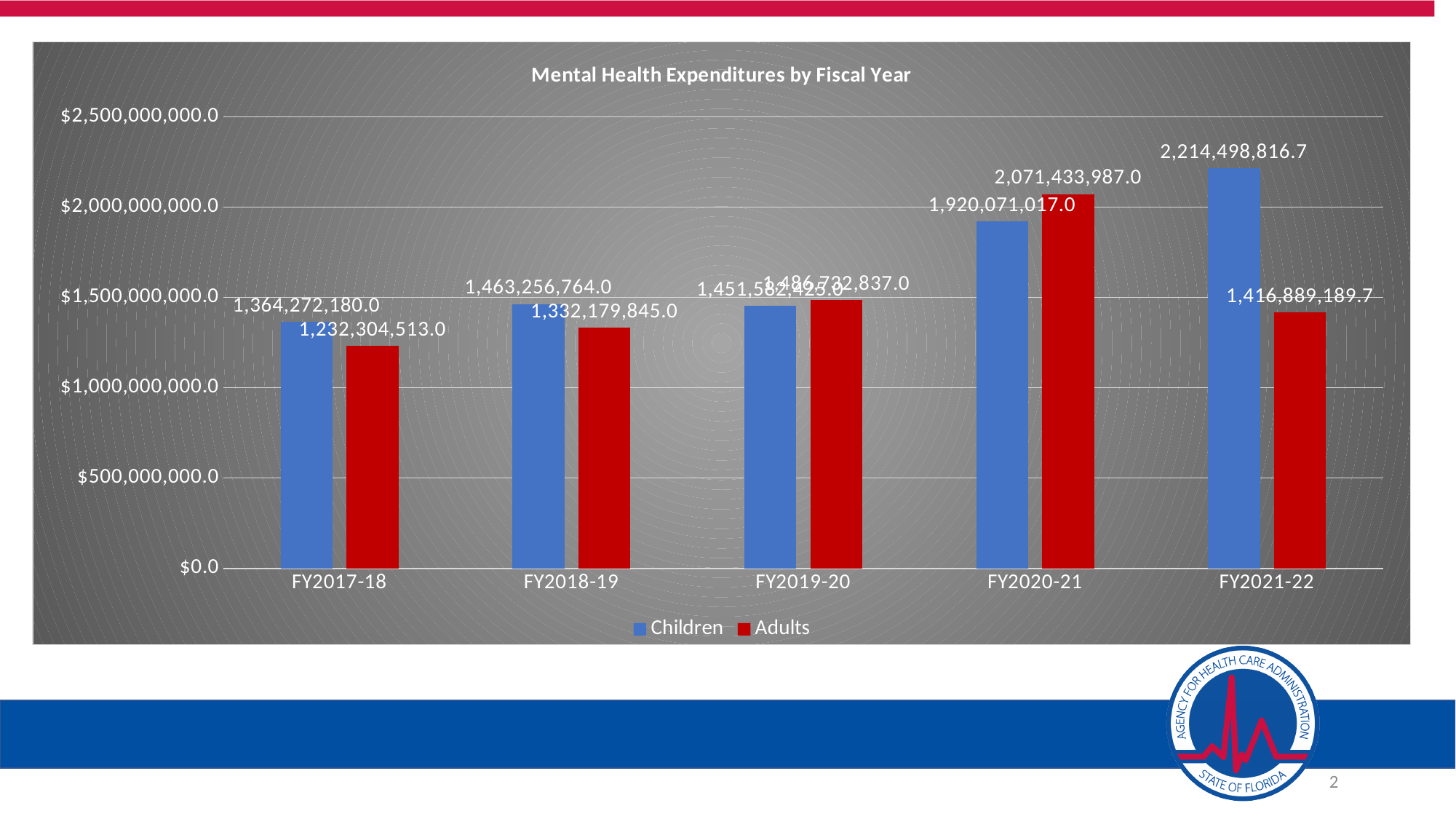
What is the Children expenditure for FY2017-18? 1,364,272,180.0 How many series does the legend list? 2 Is the Adults expenditure for FY2021-22 greater or less than $1,500,000,000.0? less What is the Adults expenditure for FY2021-22? 1,416,889,189.7 What is the difference between the Children and Adults expenditures in FY2021-22? 797,609,627.0 What is the Children expenditure for FY2018-19? 1,463,256,764.0 How many fiscal years are shown on the x axis? 5 In which fiscal year is the Adults expenditure lowest? FY2017-18 What is the Adults expenditure for FY2020-21? 2,071,433,987.0 In which fiscal year is the Children expenditure highest? FY2021-22 In FY2020-21, which is larger: the Children or the Adults expenditure? Adults What type of chart is shown on the slide? bar chart